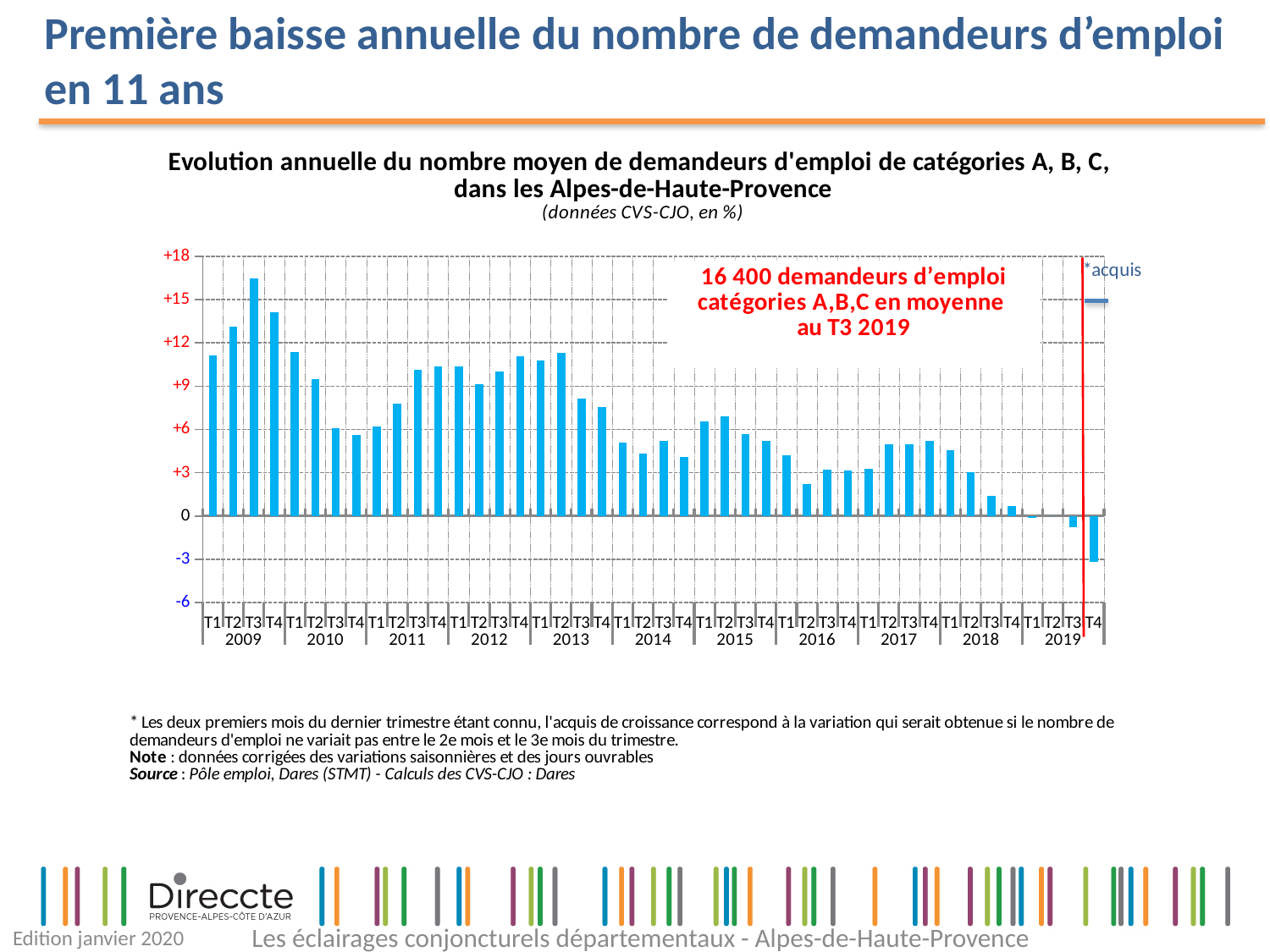
Overall, do the values rise or fall from 2009 to 2019? fall Is the value for T4 2019 greater or less than 0? less According to the text box on the chart, how many demandeurs d'emploi catégories A,B,C were there on average in T3 2019? 16 400 What kind of chart is shown on the slide? bar chart Is the value for T2 2013 greater or less than +9? greater Which quarter has the lowest value in the chart? T4 2019 How many quarterly bars are plotted in the chart? 44 Which is larger, the value for T3 2009 or the value for T4 2009? T3 2009 Is the value for T3 2009 greater or less than +15? greater Which quarter has the highest value in the chart? T3 2009